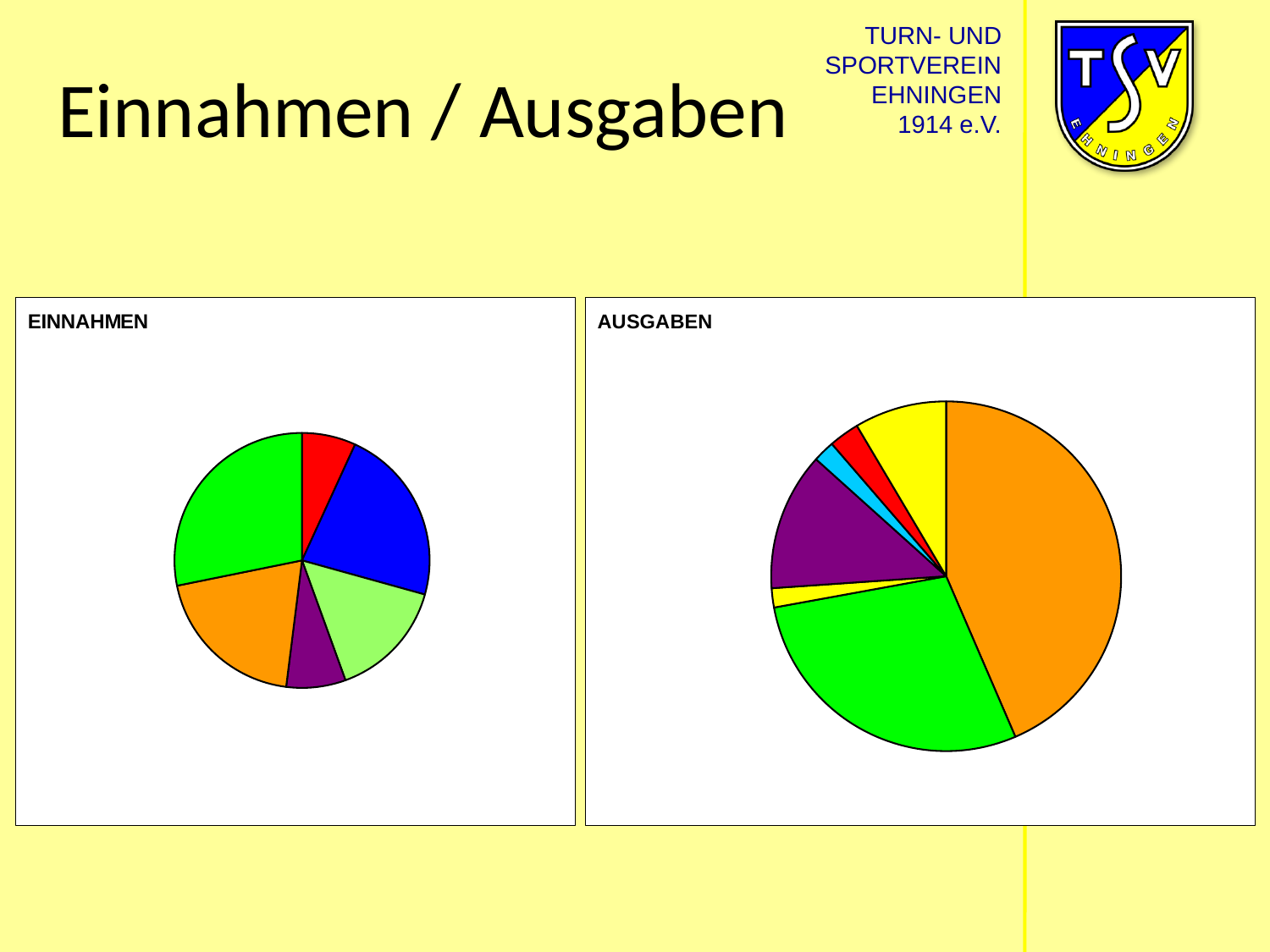
What is the title of the pie chart on the right? AUSGABEN In the EINNAHMEN pie chart, which is larger, the bright green slice or the light green slice? bright green In the AUSGABEN pie chart, which is larger, the purple slice or the red slice? purple What kind of chart is the EINNAHMEN chart on the left? pie chart In the AUSGABEN pie chart, which colour slice is the largest? orange In the AUSGABEN pie chart, which is larger, the orange slice or the green slice? orange How many slices does the AUSGABEN pie chart have? 7 How many slices does the EINNAHMEN pie chart have? 6 What is the title of the pie chart on the left? EINNAHMEN What kind of chart is the AUSGABEN chart on the right? pie chart